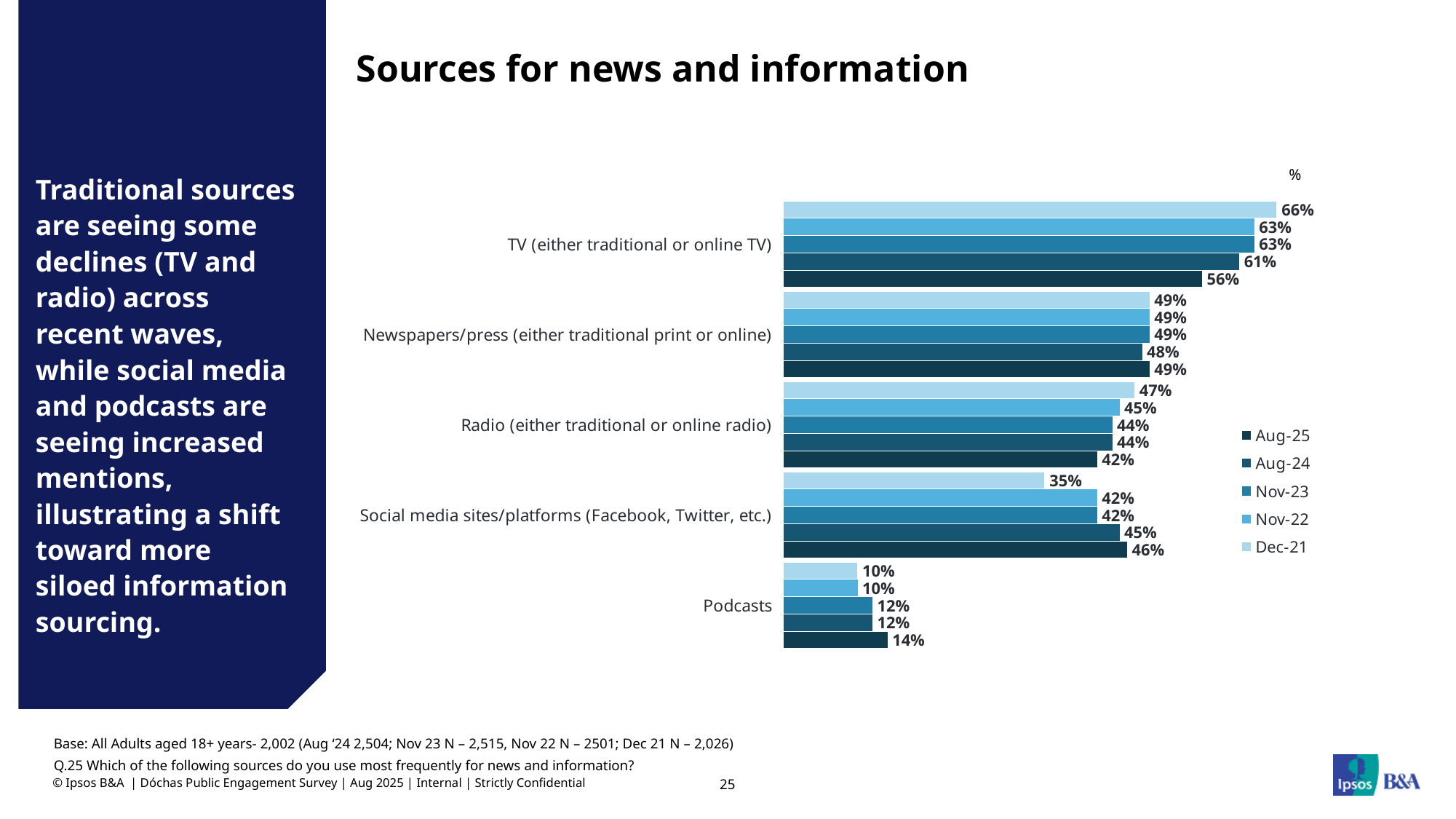
What is the Aug-25 value for TV (either traditional or online TV)? 56% What is the Dec-21 value for Social media sites/platforms (Facebook, Twitter, etc.)? 35% How many series does the legend list? 5 Which category has the lowest Aug-25 value? Podcasts What is the Aug-25 value for Podcasts? 14% What type of chart is shown on the slide? bar chart Do the values for Social media sites/platforms rise or fall from Dec-21 to Aug-25? rise What is the difference between the Dec-21 and Aug-25 values for TV (either traditional or online TV)? 10% How many news source categories are shown in the chart? 5 Which category has the highest Dec-21 value? TV (either traditional or online TV) Which is larger for Radio (either traditional or online radio): the Dec-21 value or the Aug-25 value? Dec-21 Which series is shown in the darkest colour in the legend? Aug-25